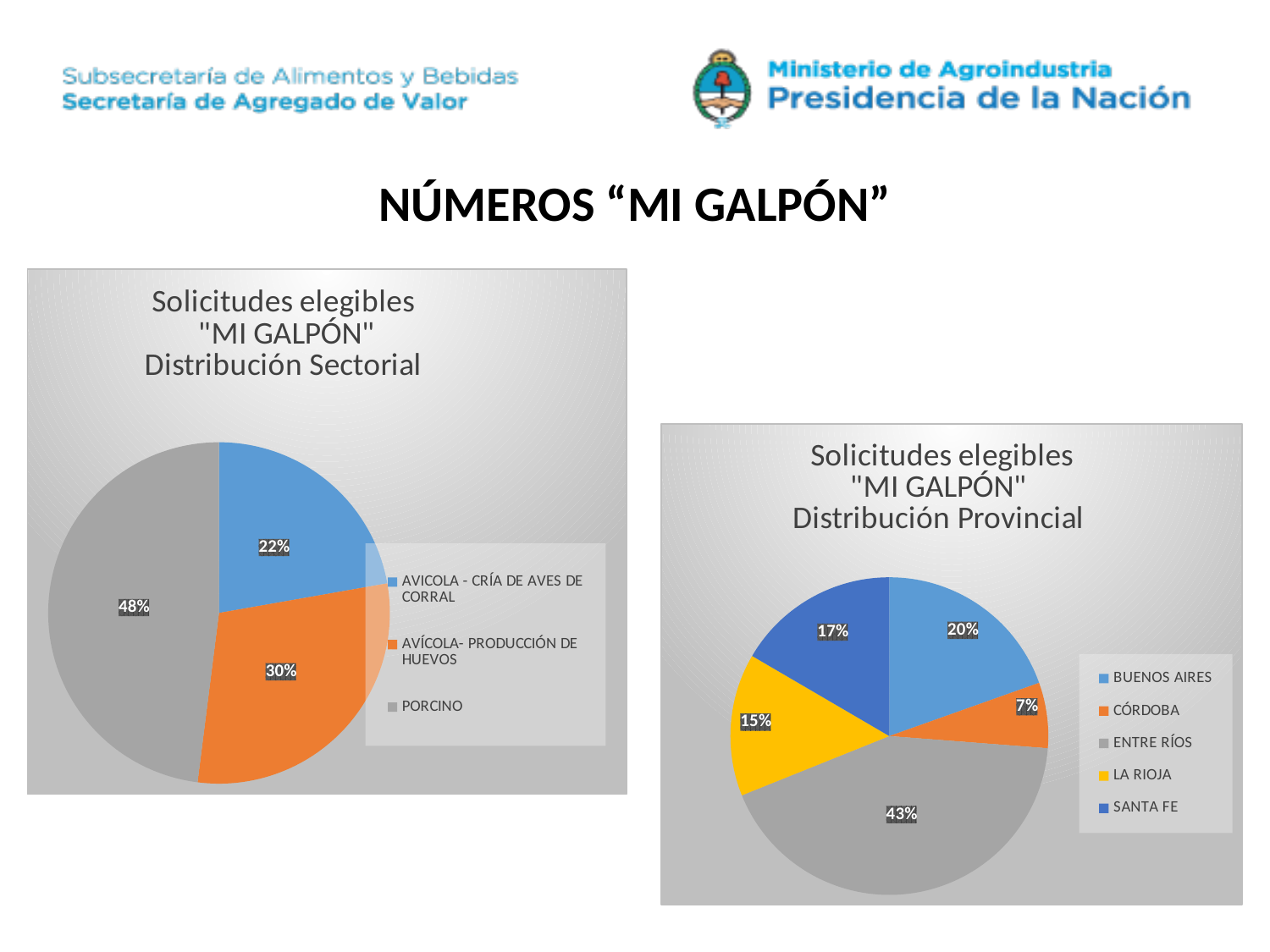
In the 'Distribución Provincial' chart, what share does CÓRDOBA have? 7% In the 'Distribución Provincial' chart, how many provinces are shown? 5 In the 'Distribución Provincial' chart, what colour is the LA RIOJA slice? Yellow In the 'Distribución Sectorial' chart, what is the difference in percentage points between PORCINO and AVÍCOLA- PRODUCCIÓN DE HUEVOS? 18 percentage points In the 'Distribución Sectorial' chart, which category has the smallest slice? AVICOLA - CRÍA DE AVES DE CORRAL In the 'Distribución Provincial' chart, which is larger, BUENOS AIRES or SANTA FE? BUENOS AIRES In the 'Distribución Provincial' chart, which province has the smallest slice? CÓRDOBA In the 'Distribución Provincial' chart, what share does ENTRE RÍOS have? 43% In the 'Distribución Sectorial' chart, which category has the largest slice? PORCINO What type of chart is the 'Distribución Provincial' chart? Pie chart In the 'Distribución Sectorial' chart, what share does AVÍCOLA- PRODUCCIÓN DE HUEVOS have? 30%